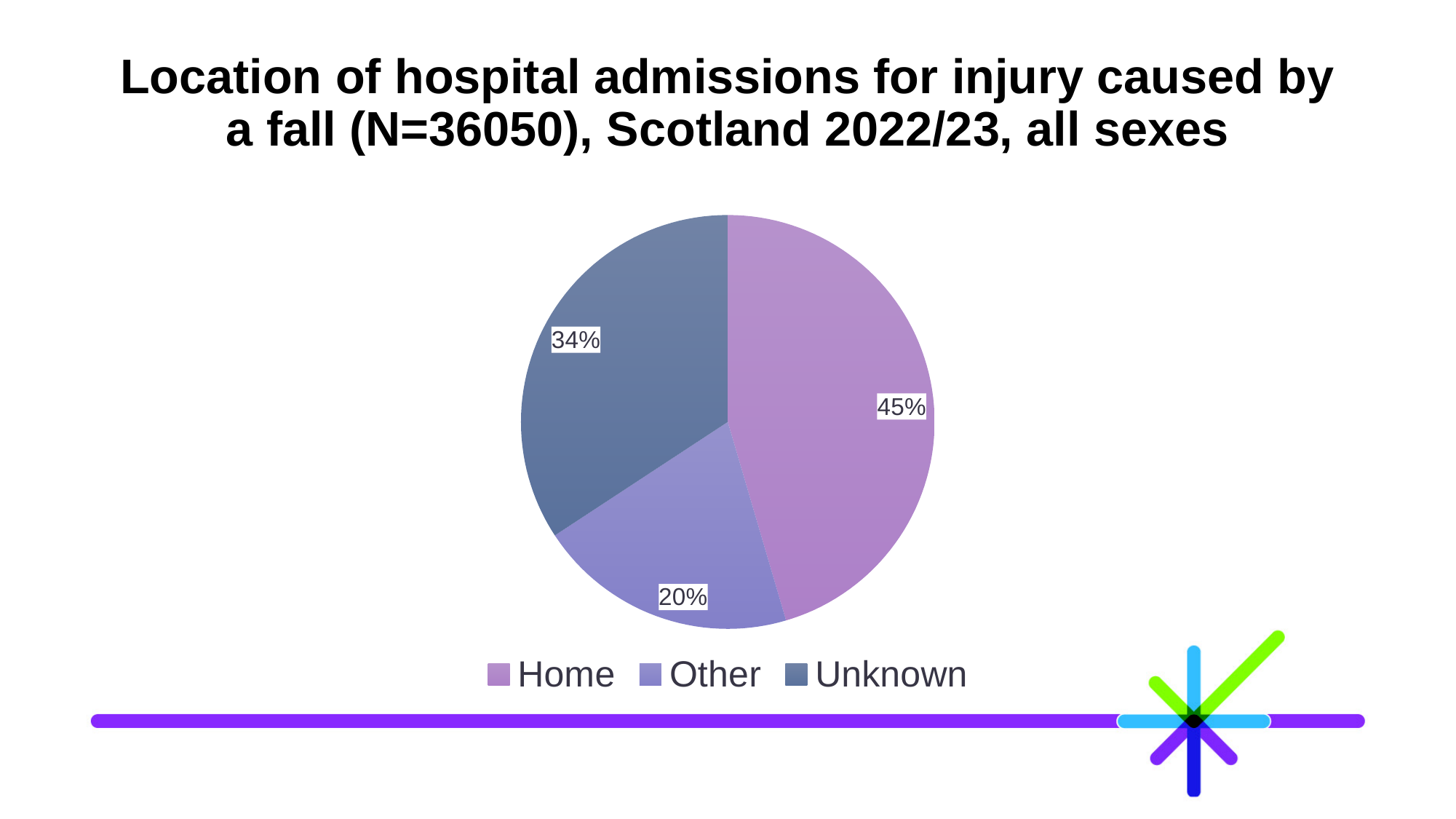
Which location category has the largest share of admissions? Home What percentage of admissions has an Unknown location? 34% What share of hospital admissions for injury caused by a fall occurred at Home? 45% Which legend entry is shown in the darkest blue-grey colour? Unknown Which location category has the smallest share of admissions? Other What is the difference in percentage points between the Home and Unknown shares? 11 What is the total number of admissions (N) stated in the chart title? 36050 What kind of chart is shown on the slide? Pie chart Which is larger, the share for Other or the share for Unknown? Unknown How many location categories are shown in the pie chart? 3 What percentage of admissions is labelled Other? 20% What is the difference in percentage points between the Unknown and Other shares? 14